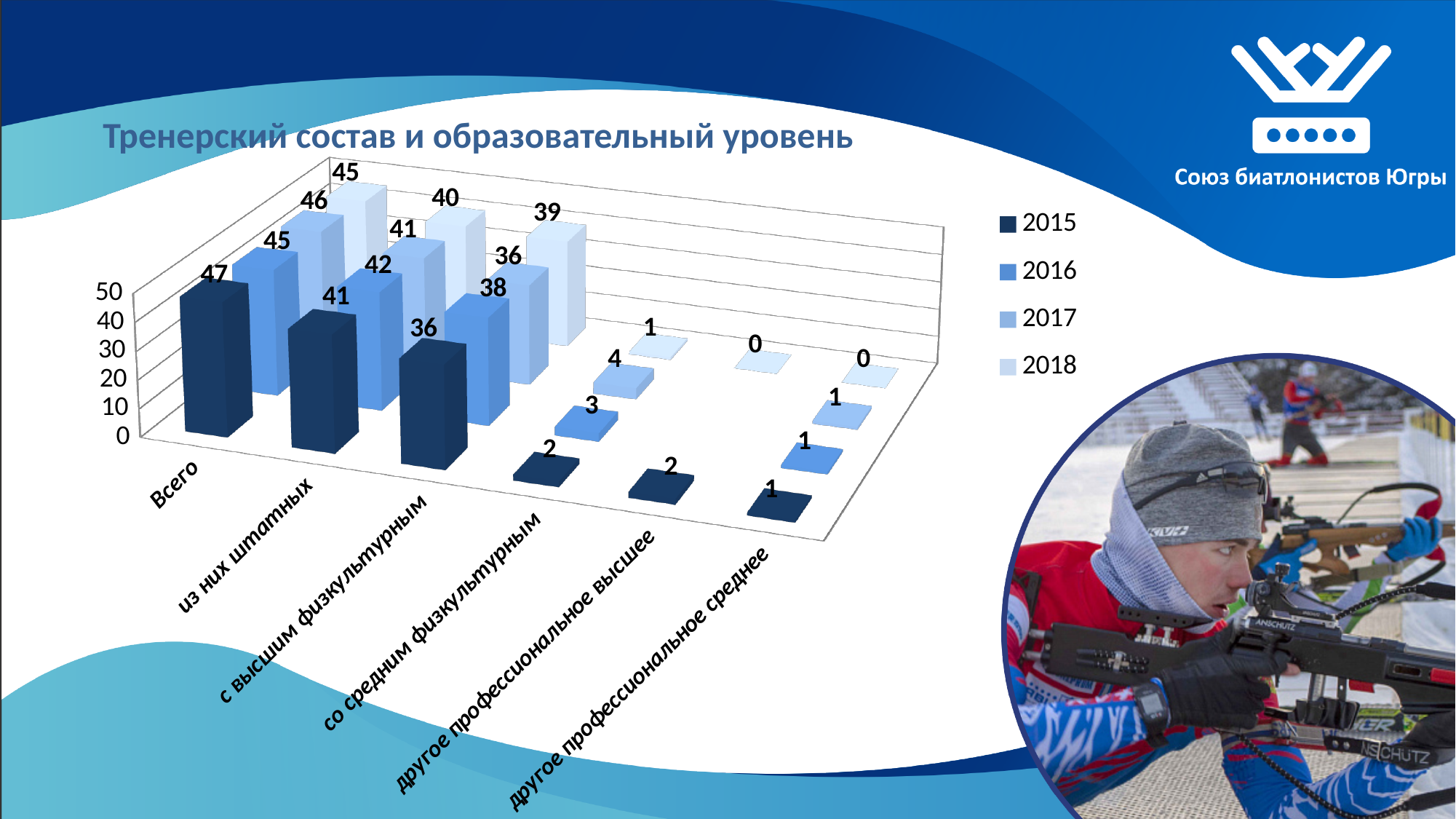
What is the title of the chart? Тренерский состав и образовательный уровень What is the value for 2016 in the category "из них штатных"? 42 What is the value for 2017 in the category "со средним физкультурным"? 4 What kind of chart is shown on the slide? bar chart How many categories are shown on the x axis? 6 Which year has the lowest value in the category "со средним физкультурным"? 2018 What is the value for 2018 in the category "с высшим физкультурным"? 39 Which is larger: the 2016 value or the 2018 value for "с высшим физкультурным"? 2018 What is the value for 2015 in the category "Всего"? 47 What is the difference between the 2015 and 2018 values in the category "Всего"? 2 Which year has the highest value in the category "Всего"? 2015 How many series does the legend list? 4